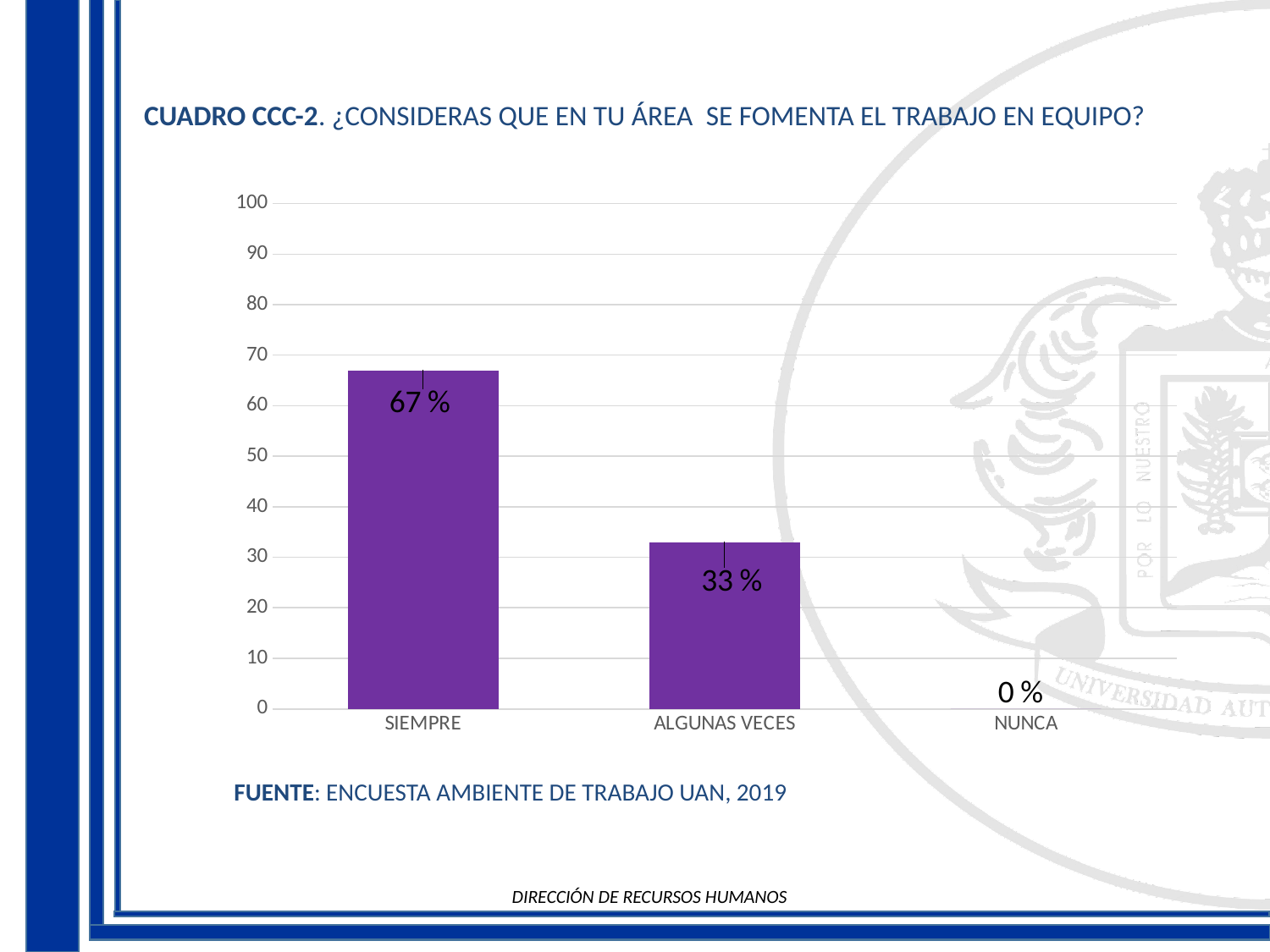
What is the difference between the values for SIEMPRE and ALGUNAS VECES? 34 % Is the value for SIEMPRE greater or less than 60? greater Is the value for ALGUNAS VECES greater or less than 40? less Which category has the highest value? SIEMPRE What is the value for SIEMPRE? 67 % How many categories are shown on the x axis? 3 What is the value for ALGUNAS VECES? 33 % What kind of chart is shown on the slide? bar chart What is the value for NUNCA? 0 % Which is larger, the value for SIEMPRE or the value for ALGUNAS VECES? SIEMPRE What source is cited below the chart? ENCUESTA AMBIENTE DE TRABAJO UAN, 2019 Which category has the lowest value? NUNCA